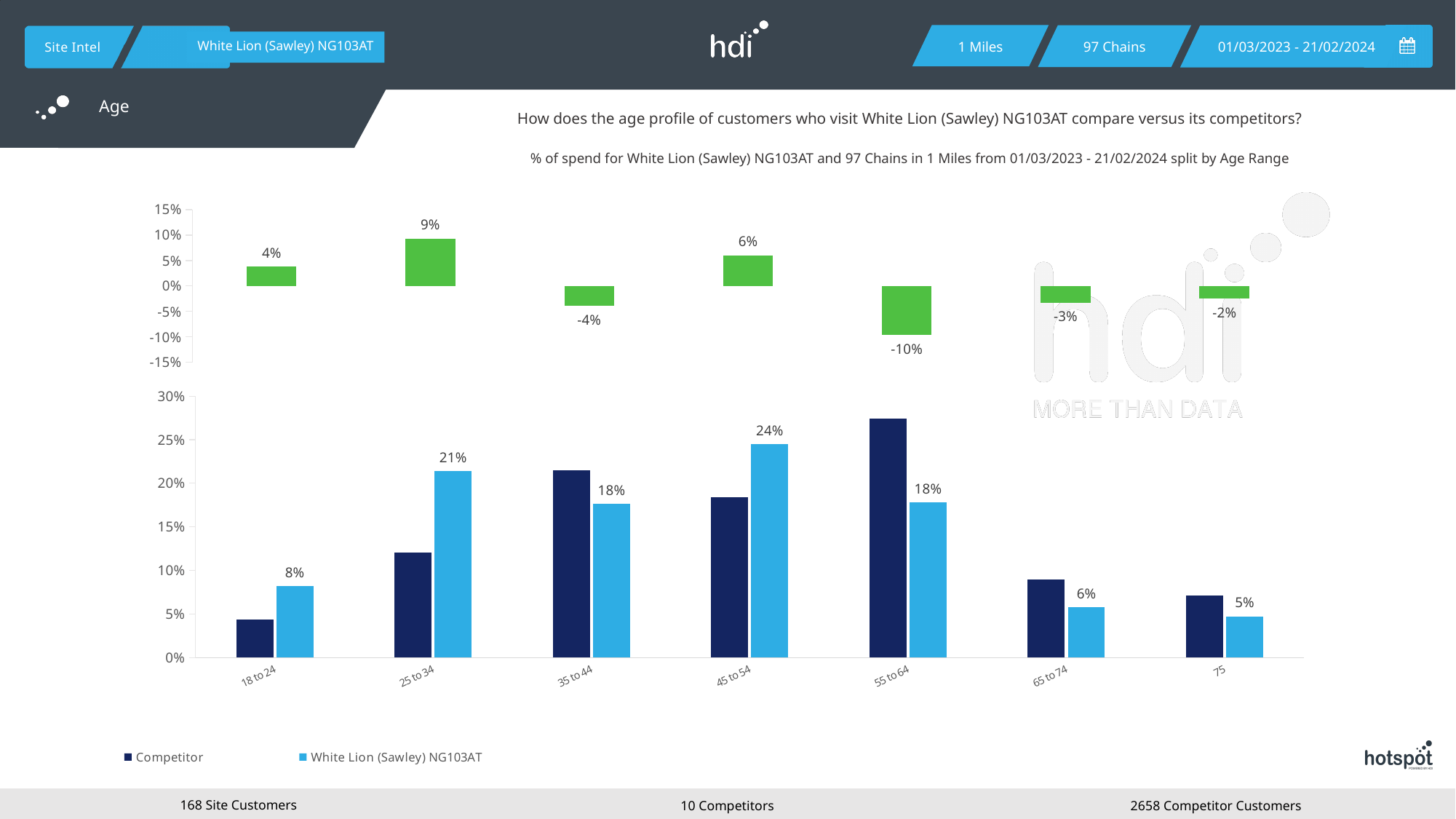
In the top chart, what is the value shown for the 55 to 64 age range? -10% In the bottom chart, is the Competitor value for 55 to 64 greater or less than 25%? greater In the bottom chart, what is the difference between the White Lion (Sawley) NG103AT values for 25 to 34 and 65 to 74? 15% In the bottom chart, which age range has the lowest value for White Lion (Sawley) NG103AT? 75 In the bottom chart, what is the value for White Lion (Sawley) NG103AT in the 45 to 54 age range? 24% In the bottom chart, for the 55 to 64 age range, which series has the larger value, Competitor or White Lion (Sawley) NG103AT? Competitor In the top chart, which age range has the highest value? 25 to 34 How many series does the legend of the bottom chart list? 2 How many age range categories are shown on the x axis of the bottom chart? 7 What type of chart is the bottom chart? Bar chart In the bottom chart, what is the value for White Lion (Sawley) NG103AT in the 18 to 24 age range? 8%